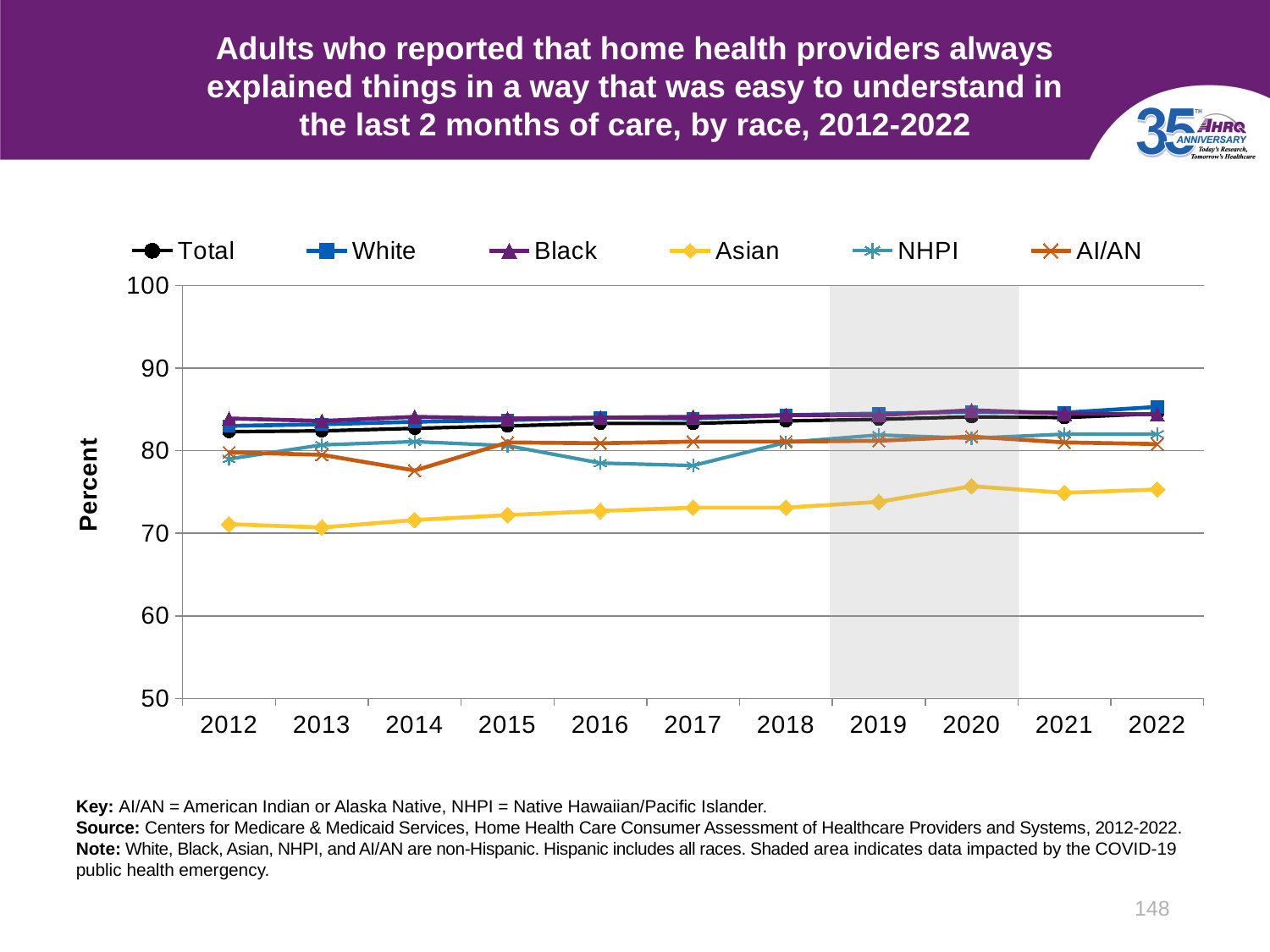
What kind of chart is shown on the slide? line chart Which series has the lowest value in 2022? Asian How many years are shown along the x axis? 11 Is the value for Asian in 2022 greater or less than 70? greater Which series has the lowest value in 2012? Asian Is the value for Asian in 2020 greater or less than 80? less Is the value for Total in 2012 greater or less than 80? greater How many series does the legend list? 6 Does the Asian series rise or fall from 2012 to 2022? rise What does the shaded area on the chart indicate? Data impacted by the COVID-19 public health emergency Which is larger in 2012, the value for NHPI or the value for Asian? NHPI